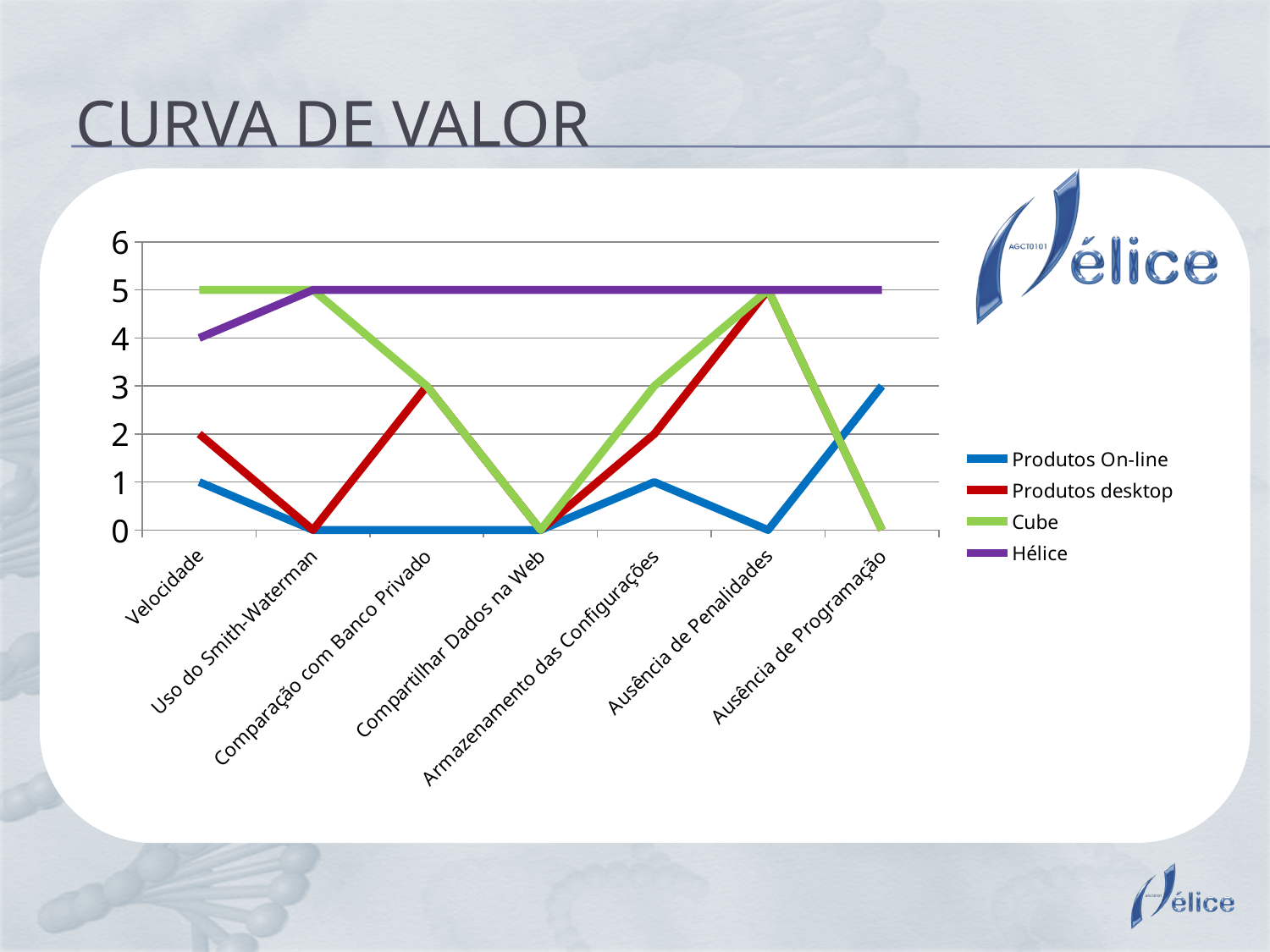
What kind of chart is shown on the slide? Line chart Which is larger for Ausência de Programação: Produtos On-line or Cube? Produtos On-line How many series does the legend list? 4 What is the value of Hélice for Velocidade? 4 How many categories are shown on the x axis? 7 What is the value of Produtos On-line for Ausência de Programação? 3 What is the value of Produtos desktop for Comparação com Banco Privado? 3 What is the value of Cube for Compartilhar Dados na Web? 0 What is the title of the slide containing the chart? CURVA DE VALOR Which series has the lowest value for Ausência de Penalidades? Produtos On-line What is the difference between Hélice and Produtos On-line for Armazenamento das Configurações? 4 Which series has the highest value for Velocidade? Cube